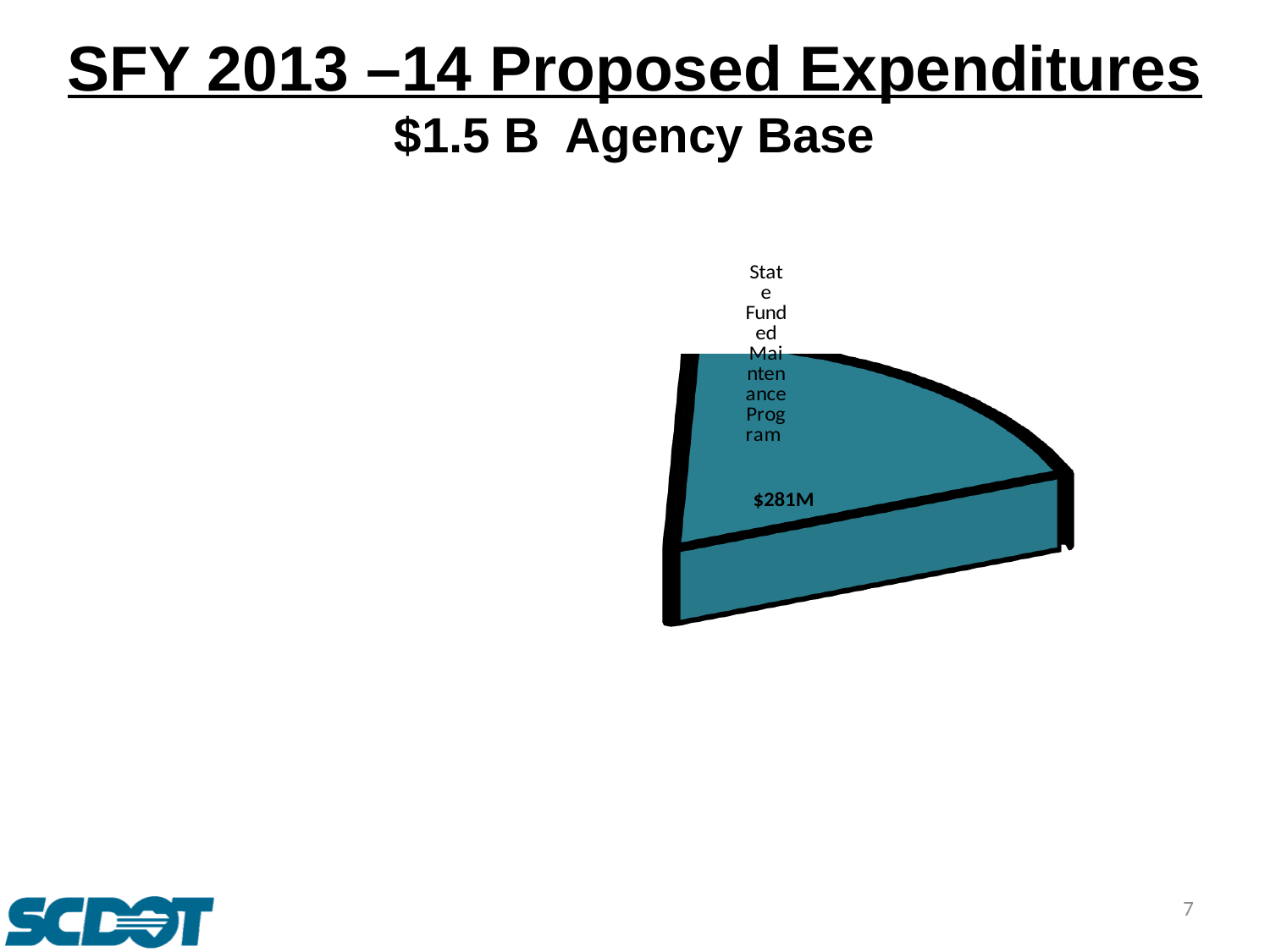
What value is shown for the State Funded Maintenance Program slice? $281M How many slices are visible in the pie chart? 1 What kind of chart is shown on the slide? pie chart Which category is labelled on the visible pie slice? State Funded Maintenance Program What is the title of the slide containing the chart? SFY 2013 –14 Proposed Expenditures